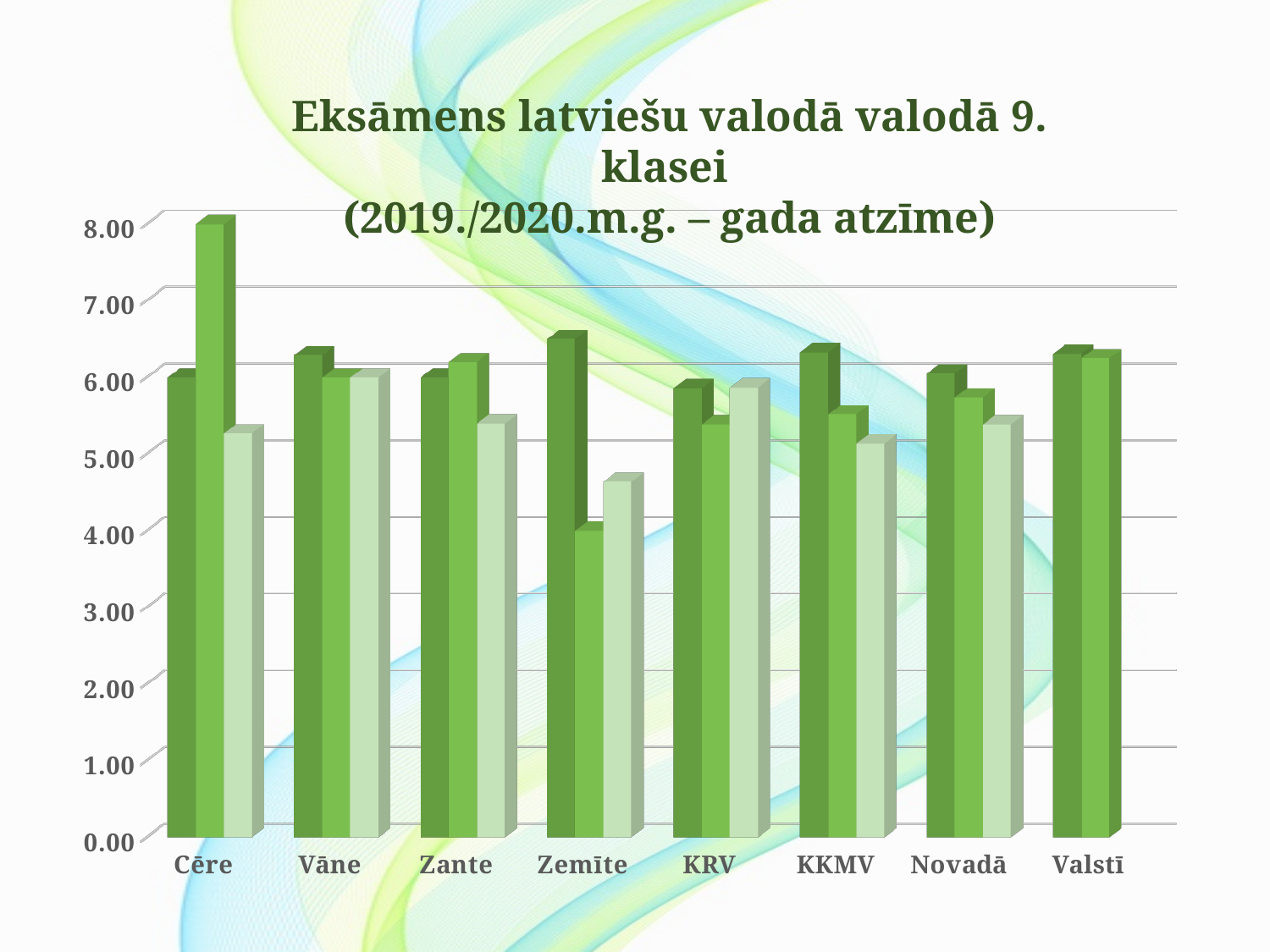
How many categories are shown along the x axis? 8 Which category contains the tallest bar in the chart? Cēre Is the value of the middle (medium-green) bar for Zemīte greater or less than 5.00? less Which category contains the shortest bar in the chart? Zemīte How many bars are shown for the Valstī category? 2 Is the value of the light-green (rightmost) bar for Novadā greater or less than 5.00? greater What kind of chart is shown on the slide? bar chart Is the value of the tallest (middle, medium-green) bar for Cēre greater or less than 7.00? greater Which is larger: the middle (medium-green) bar for Cēre or the middle (medium-green) bar for Zemīte? Cēre What is the title of the chart? Eksāmens latviešu valodā valodā 9. klasei (2019./2020.m.g. – gada atzīme)